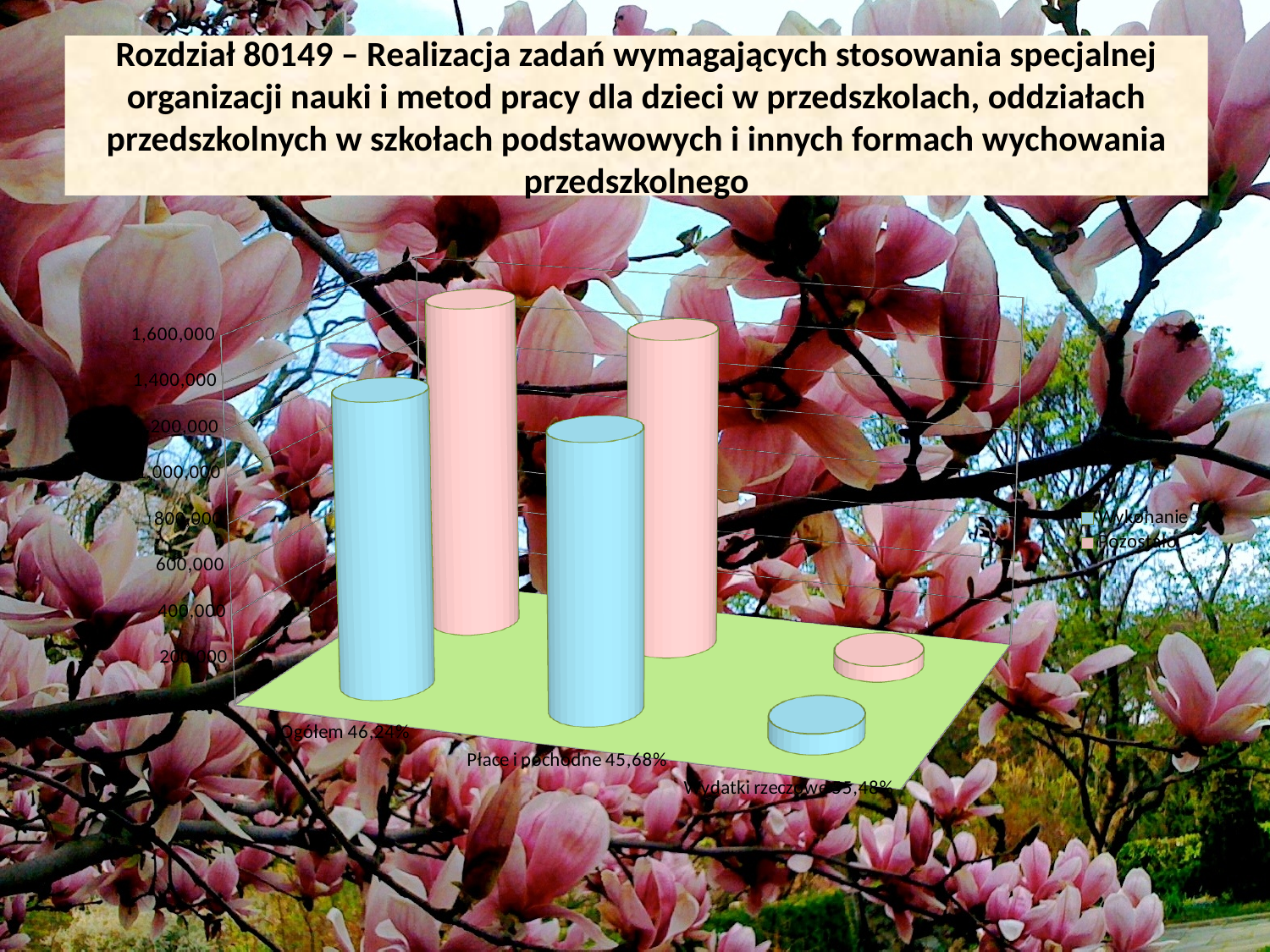
What are the two series named in the chart legend? Wykonanie and Pozostało Which category has the highest Pozostało value? Ogółem 46,24% Is the Wykonanie value for Płace i pochodne 45,68% greater or less than 600,000? greater Which category has the lowest Pozostało value? Wydatki rzeczowe 55,48% Which is larger: the Pozostało value for Ogółem 46,24% or the Pozostało value for Wydatki rzeczowe 55,48%? Ogółem 46,24% What kind of chart is shown on the slide? bar chart How many categories are shown on the chart's category axis? 3 Which colour represents the Pozostało series in the chart? pink Which category has the lowest Wykonanie value? Wydatki rzeczowe 55,48% How many series does the chart legend list? 2 Is the Wykonanie value for Wydatki rzeczowe 55,48% greater or less than 400,000? less Is the Pozostało value for Ogółem 46,24% greater or less than 1,000,000? greater